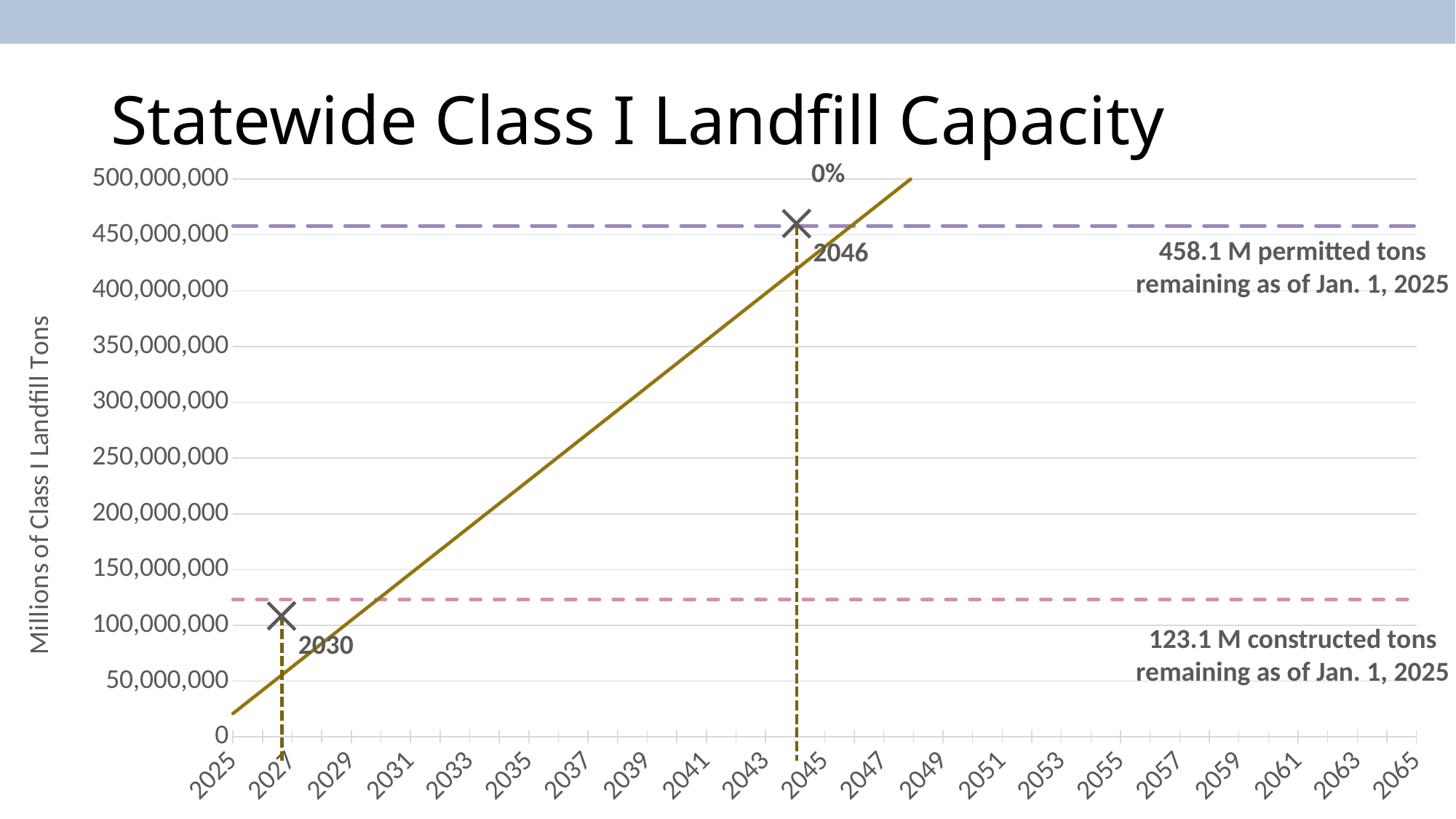
In which year does the chart mark the constructed capacity being reached? 2030 What is the label on the vertical axis of the chart? Millions of Class I Landfill Tons How many constructed tons were remaining as of Jan. 1, 2025, according to the chart? 123.1 M What is the last year shown on the x axis? 2065 Which is larger, the permitted tons remaining or the constructed tons remaining? permitted tons remaining What is the difference between the permitted tons remaining and the constructed tons remaining as of Jan. 1, 2025? 335.0 M What is the title of the chart? Statewide Class I Landfill Capacity Does the solid cumulative line rise or fall as the years increase along the x axis? rise In which year does the chart mark the permitted capacity being reached (0%)? 2046 How many permitted tons were remaining as of Jan. 1, 2025, according to the chart? 458.1 M Is the constructed capacity line greater or less than 100,000,000 on the vertical axis? greater What kind of chart is shown on the slide? line chart